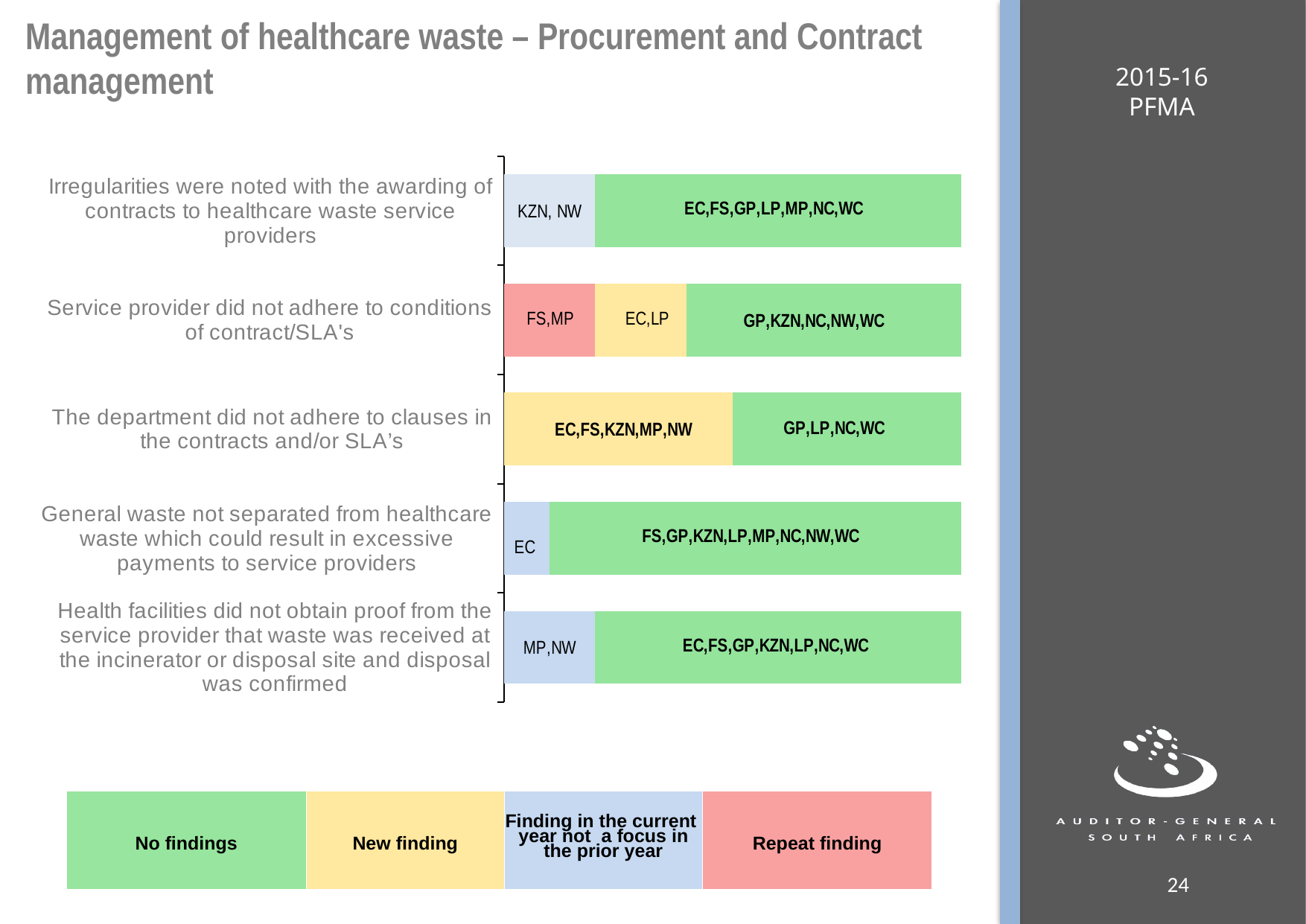
How many finding categories are plotted on the chart? 5 Which provinces are shown in the 'Finding in the current year not a focus in the prior year' segment for 'Irregularities were noted with the awarding of contracts to healthcare waste service providers'? KZN, NW How many finding statuses does the legend list? 4 How many provinces are listed as having no findings for 'Health facilities did not obtain proof from the service provider that waste was received at the incinerator or disposal site and disposal was confirmed'? 7 What kind of chart is shown on the slide? Stacked bar chart Which province is shown in the 'Finding in the current year not a focus in the prior year' segment for 'General waste not separated from healthcare waste which could result in excessive payments to service providers'? EC Which finding category has the fewest provinces with no findings? The department did not adhere to clauses in the contracts and/or SLA's Which provinces are shown as having no findings for 'Service provider did not adhere to conditions of contract/SLA's'? GP,KZN,NC,NW,WC Which provinces are shown as having a new finding for 'The department did not adhere to clauses in the contracts and/or SLA's'? EC,FS,KZN,MP,NW Which finding category has the most provinces with no findings? General waste not separated from healthcare waste which could result in excessive payments to service providers Which provinces are shown as having a repeat finding for 'Service provider did not adhere to conditions of contract/SLA's'? FS,MP What colour does the legend use for 'Repeat finding'? Red